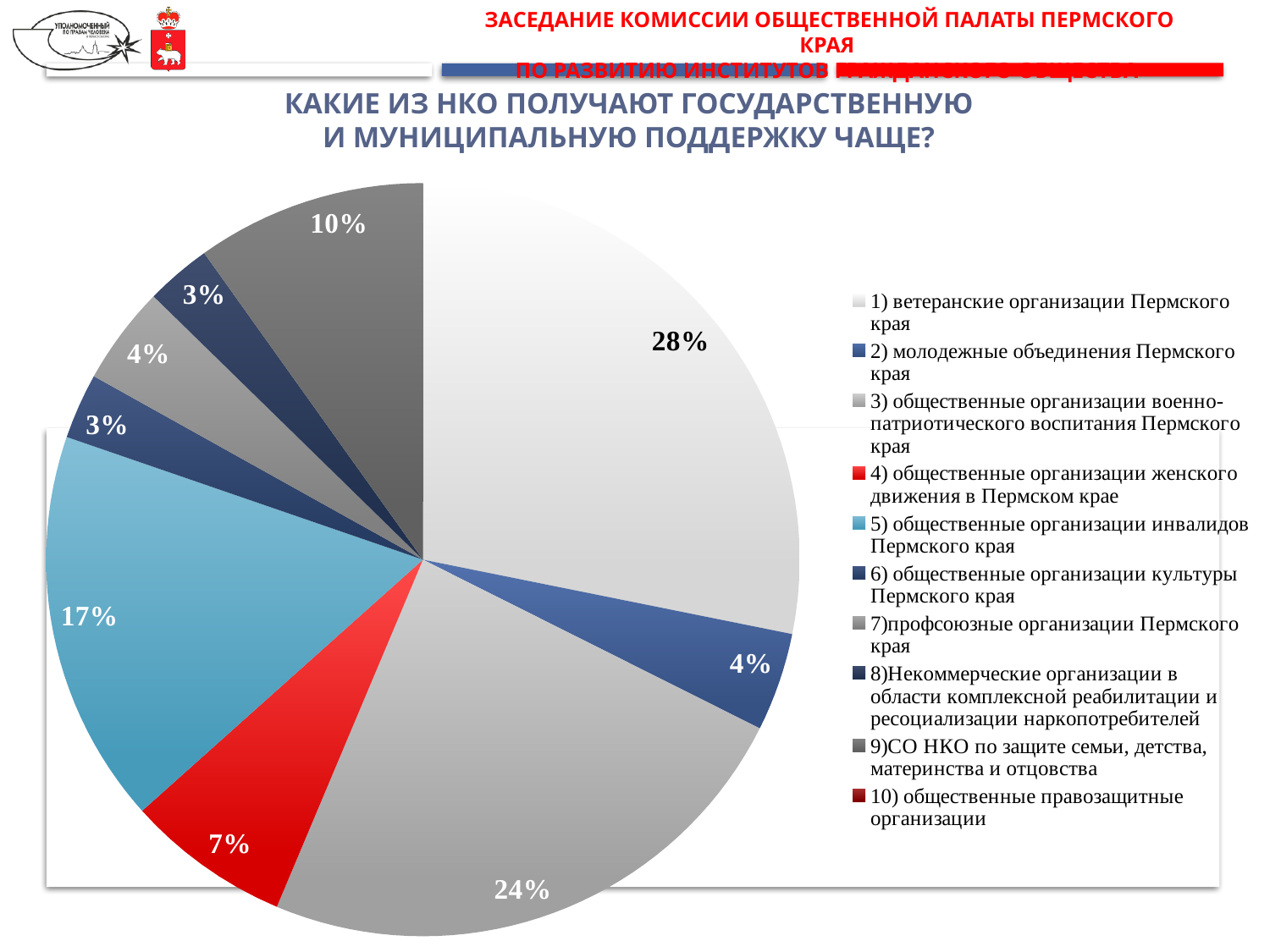
What share of the pie is labelled for "4) общественные организации женского движения в Пермском крае"? 7% How many categories does the legend of the pie chart list? 10 Which slice is larger: the one for "5) общественные организации инвалидов Пермского края" or the one for "4) общественные организации женского движения в Пермском крае"? 5) общественные организации инвалидов Пермского края What share of the pie is labelled for "1) ветеранские организации Пермского края"? 28% What is the difference in percentage points between the slice for veterans' organisations (28%) and the slice for military-patriotic organisations (24%)? 4 What share of the pie is labelled for "2) молодежные объединения Пермского края"? 4% What is the combined share of the two largest slices (28% and 24%)? 52% What kind of chart is shown on the slide? pie chart What share of the pie is labelled for "3) общественные организации военно-патриотического воспитания Пермского края"? 24% Which category has the largest slice of the pie? 1) ветеранские организации Пермского края What share of the pie is labelled for "9)СО НКО по защите семьи, детства, материнства и отцовства"? 10% What share of the pie is labelled for "5) общественные организации инвалидов Пермского края"? 17%